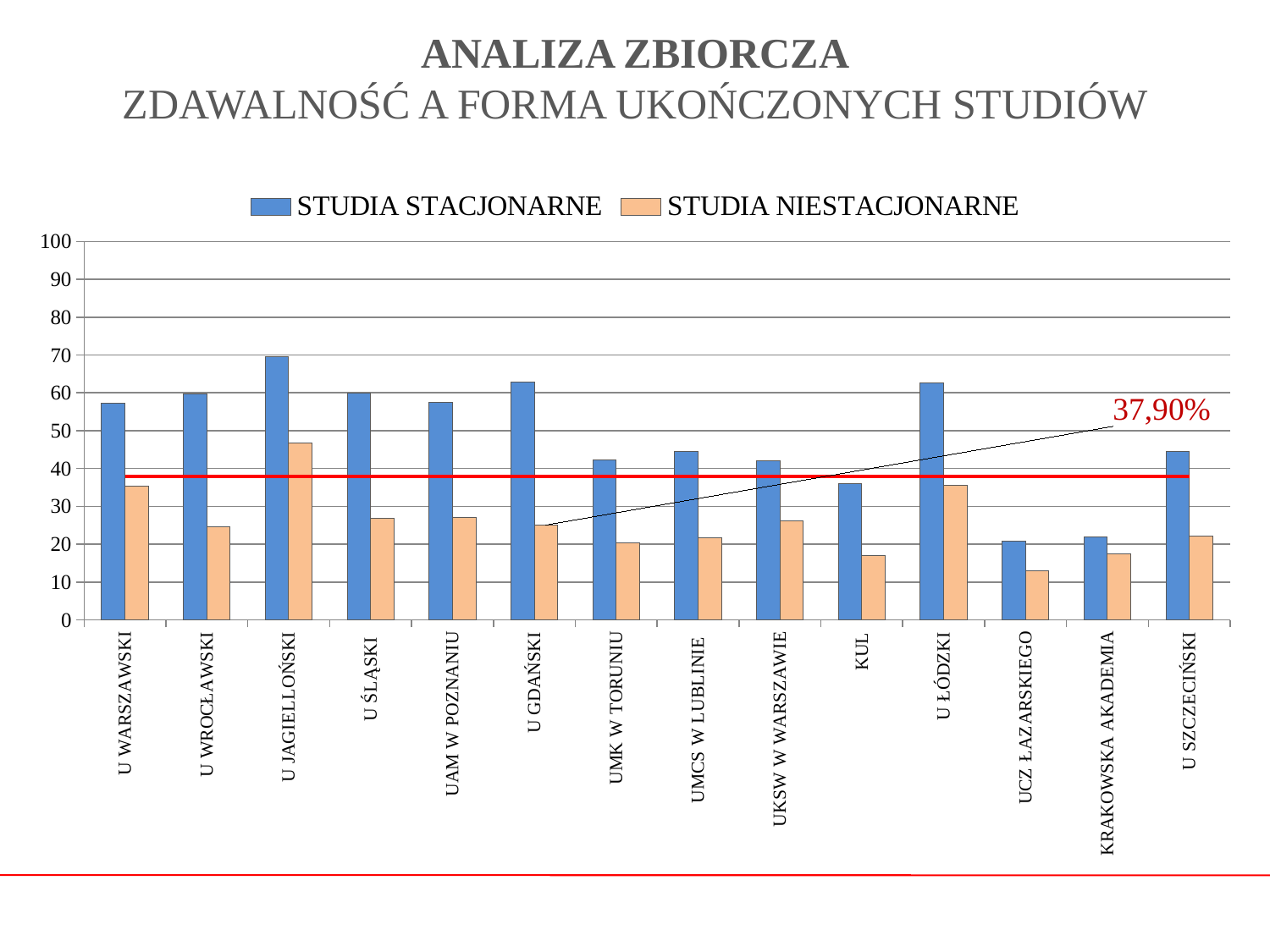
Is the STUDIA STACJONARNE value for KUL greater or less than 40? less How many universities (categories) are shown on the x axis? 14 Is the STUDIA STACJONARNE value for U JAGIELLOŃSKI greater or less than 60? greater Which is larger: the STUDIA NIESTACJONARNE value for U WARSZAWSKI or for U WROCŁAWSKI? U WARSZAWSKI What kind of chart is shown on the slide? bar chart Which university has the lowest value for STUDIA NIESTACJONARNE? UCZ ŁAZARSKIEGO Is the STUDIA NIESTACJONARNE value for U GDAŃSKI greater or less than 30? less Which university has the highest value for STUDIA STACJONARNE? U JAGIELLOŃSKI What value is labelled on the red horizontal line across the chart? 37,90% Which university has the highest value for STUDIA NIESTACJONARNE? U JAGIELLOŃSKI Which is larger: the STUDIA STACJONARNE value for U GDAŃSKI or for UMK W TORUNIU? U GDAŃSKI How many series does the legend list? 2